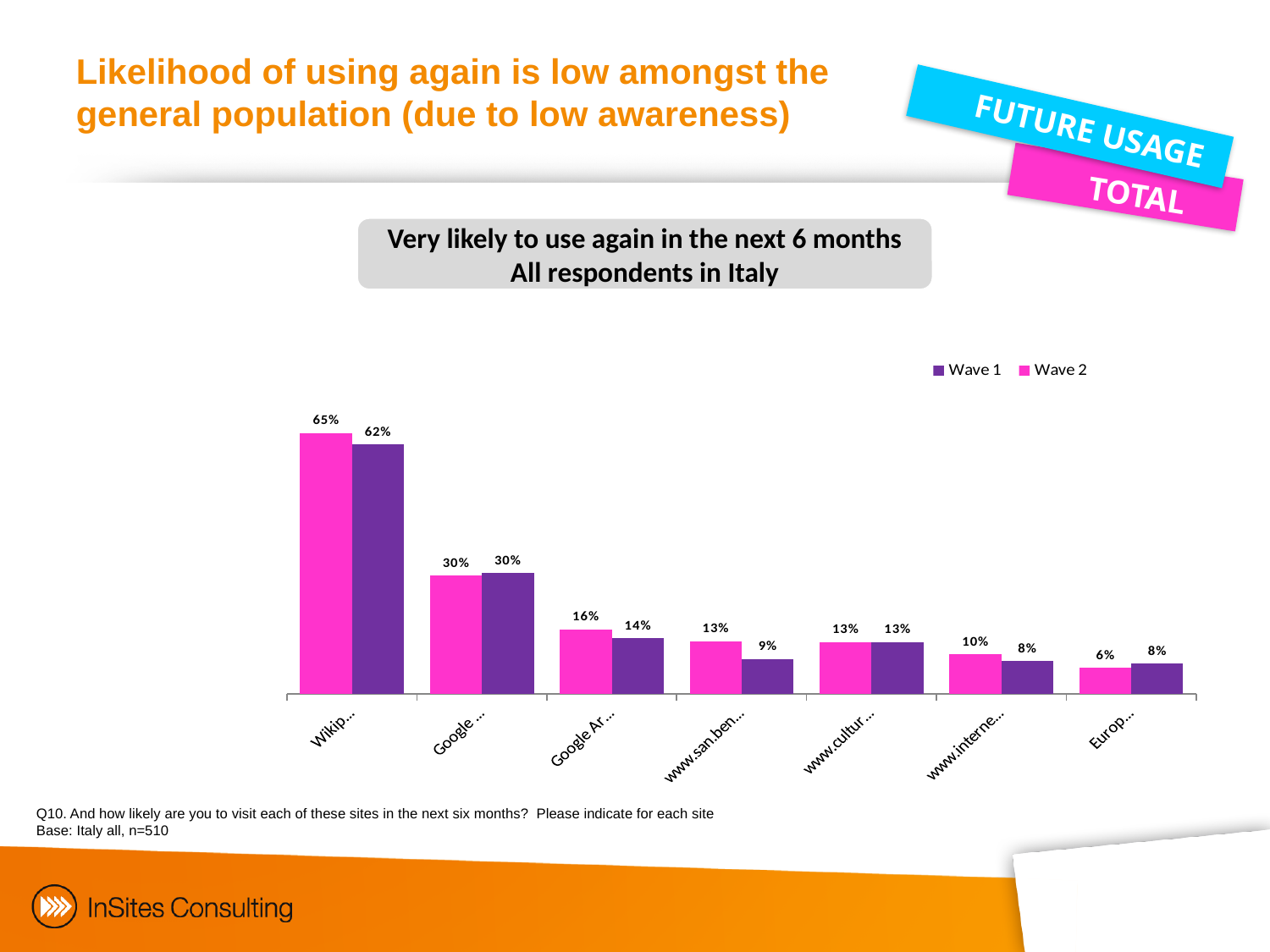
What is the Wave 1 value for the category labelled www.san.ben...? 9% How many categories are shown on the x axis of the chart? 7 How many series does the legend list? 2 Which category has the lowest Wave 2 value? Europ... What type of chart is shown on the slide? bar chart What is the Wave 2 value for the category labelled www.interne...? 10% What is the Wave 2 value for the first category (Wikip...)? 65% What is the Wave 1 value for the first category (Wikip...)? 62% Which category has the highest Wave 2 value? Wikip... For the last category (Europ...), which is larger: the Wave 1 value or the Wave 2 value? Wave 1 Which colour represents Wave 2 in the chart? pink What is the difference between the Wave 2 and Wave 1 values for the category labelled Google Ar...? 2%